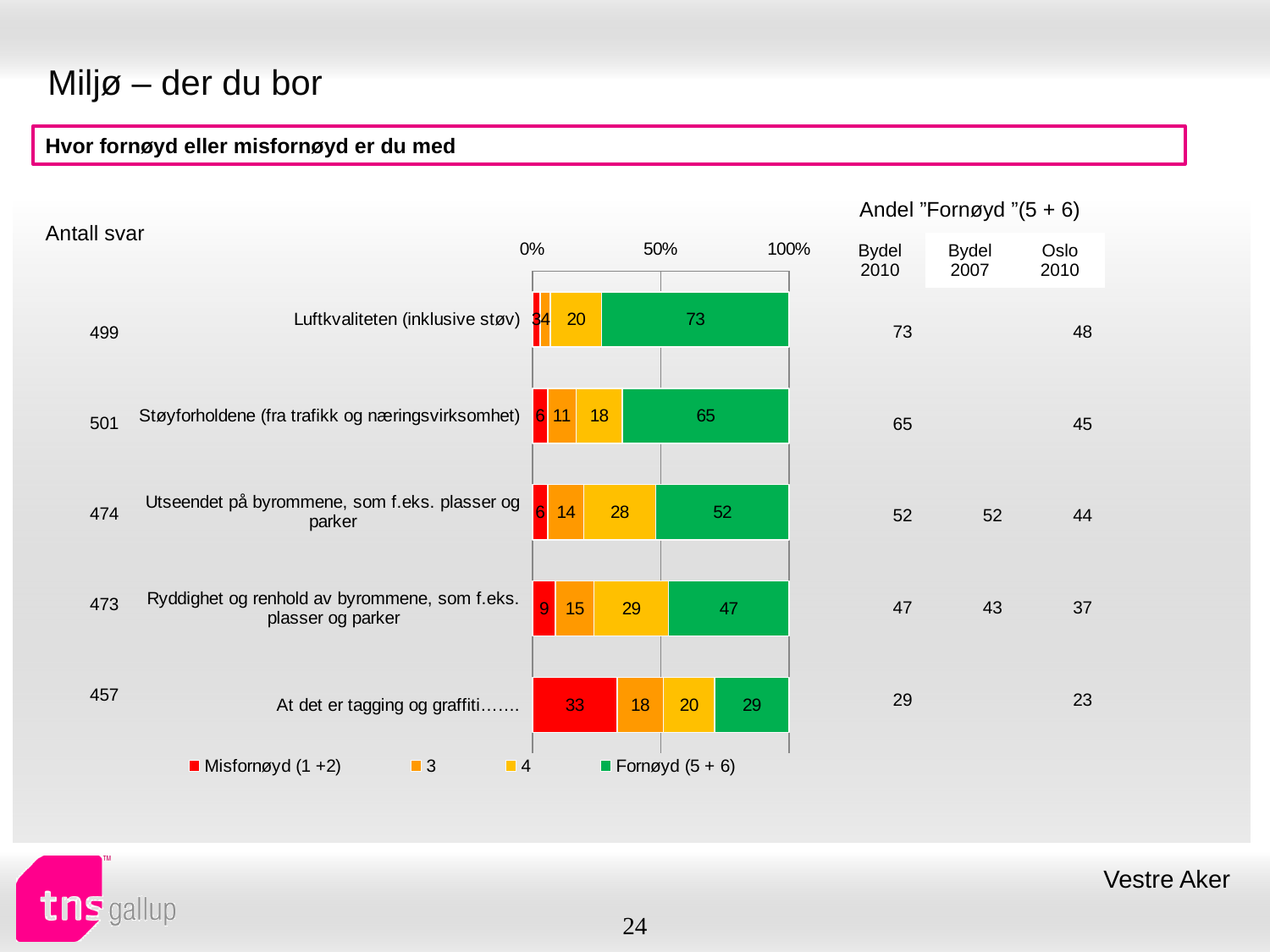
What is the value of series '4' for 'Ryddighet og renhold av byrommene, som f.eks. plasser og parker'? 29 What is the value of series '3' for 'Støyforholdene (fra trafikk og næringsvirksomhet)'? 11 How many series does the chart legend list? 4 What is the difference between the 'Fornøyd (5 + 6)' values for 'Støyforholdene (fra trafikk og næringsvirksomhet)' and 'Utseendet på byrommene, som f.eks. plasser og parker'? 13 How many categories (questions) are plotted in the chart? 5 Which category has the lowest 'Fornøyd (5 + 6)' value? At det er tagging og graffiti……. What is the 'Fornøyd (5 + 6)' value for 'Luftkvaliteten (inklusive støv)'? 73 Which category has the highest 'Fornøyd (5 + 6)' value? Luftkvaliteten (inklusive støv) Which is larger: the 'Misfornøyd (1 +2)' value for 'Ryddighet og renhold av byrommene, som f.eks. plasser og parker' or for 'Utseendet på byrommene, som f.eks. plasser og parker'? Ryddighet og renhold av byrommene, som f.eks. plasser og parker What kind of chart is shown on the slide? stacked bar chart What is the 'Misfornøyd (1 +2)' value for 'At det er tagging og graffiti…….'? 33 What colour represents the 'Fornøyd (5 + 6)' series in the chart? green